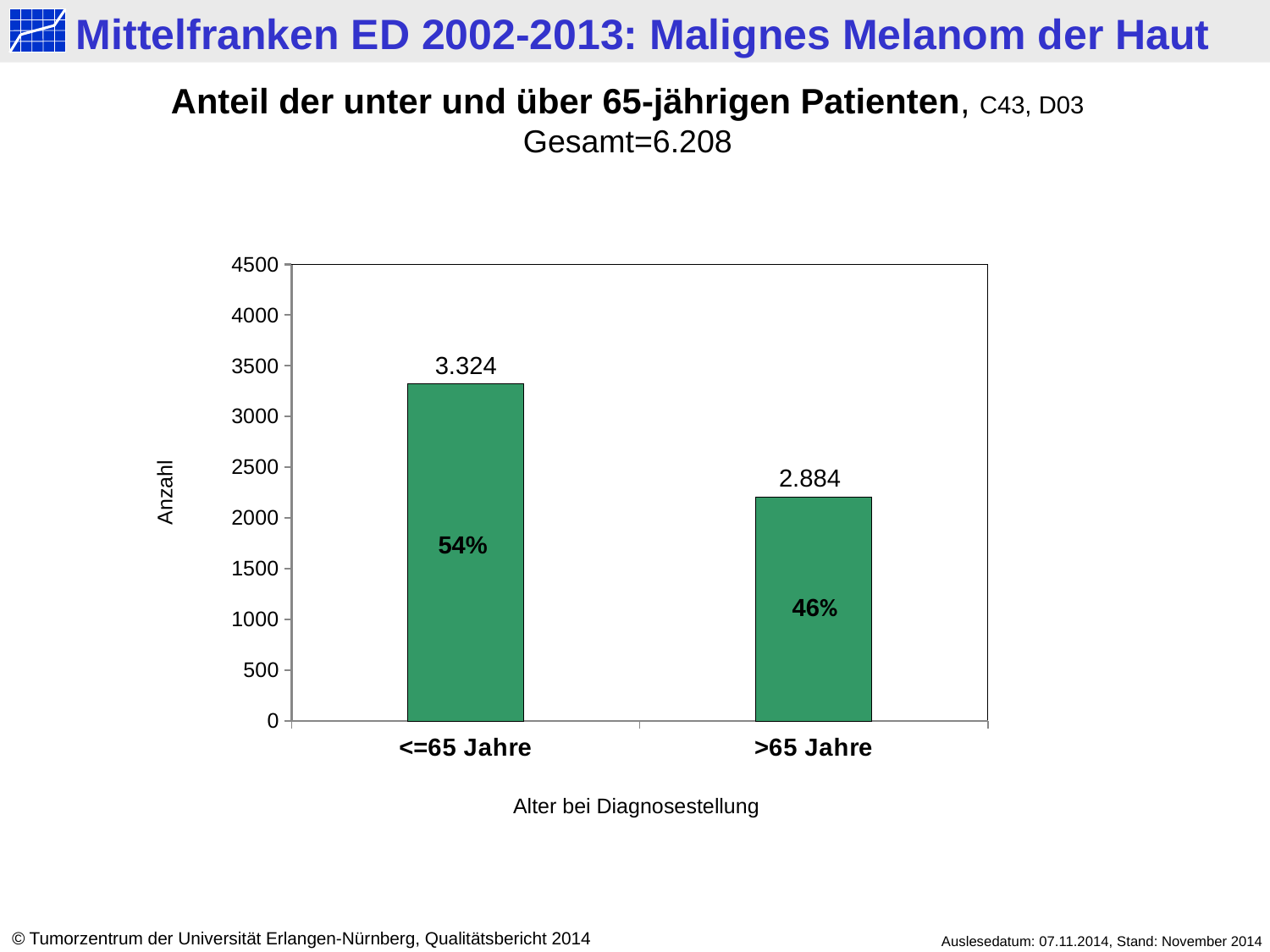
Is the value for <=65 Jahre larger or smaller than the value for >65 Jahre? larger What is the value for <=65 Jahre? 3.324 What percentage is shown on the bar for >65 Jahre? 46% Is the value for <=65 Jahre greater or less than 3000? greater What kind of chart is shown on the slide? bar chart Which age group has the lower number of patients? >65 Jahre What is the difference between the values for <=65 Jahre and >65 Jahre? 440 What is the label of the y axis? Anzahl How many categories are shown on the x axis? 2 What is the value for >65 Jahre? 2.884 Which age group has the higher number of patients? <=65 Jahre What percentage is shown on the bar for <=65 Jahre? 54%